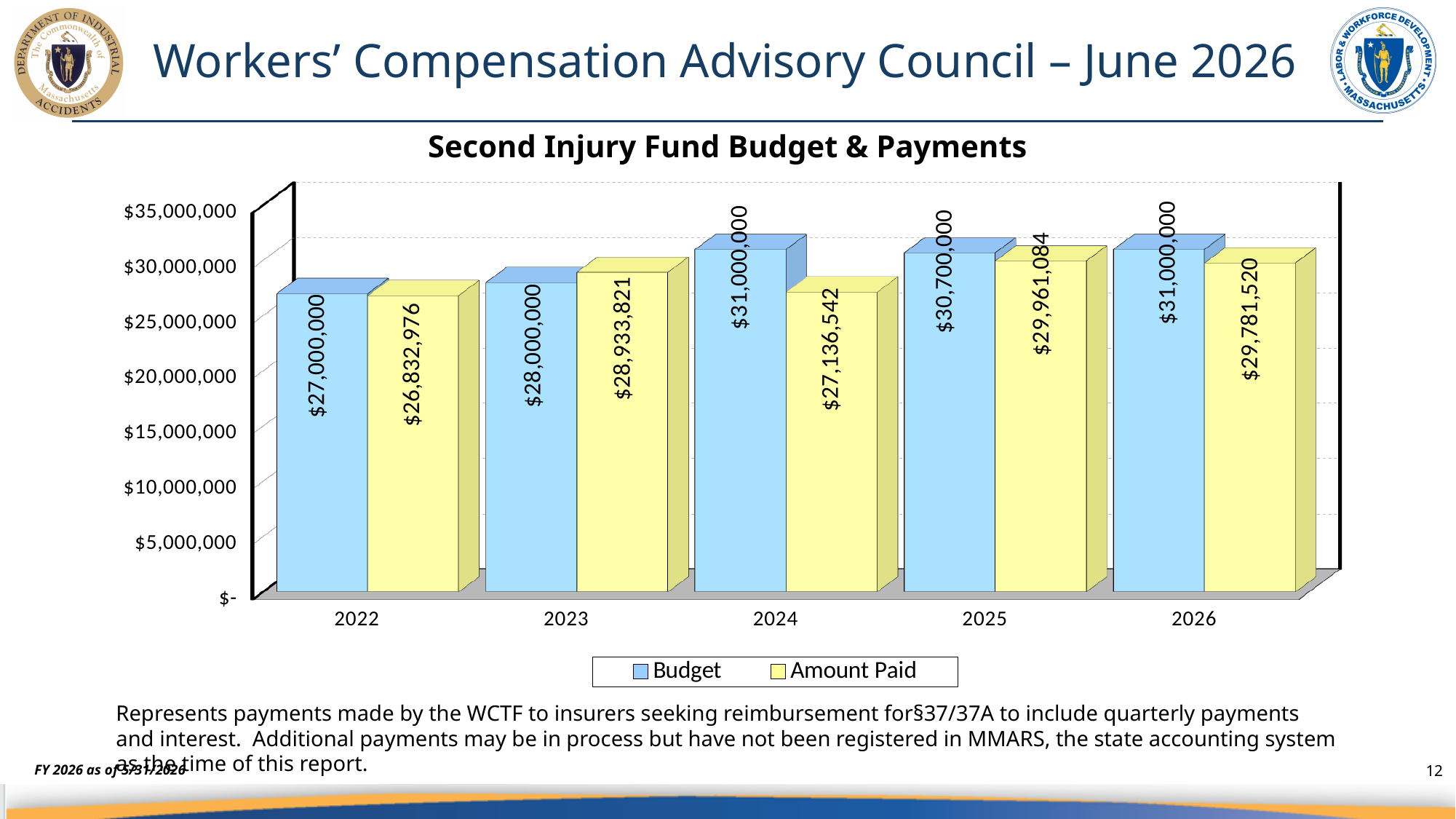
Does the Budget rise or fall from 2022 to 2024? Rise Which year has the highest Amount Paid? 2025 Which year has the lowest Amount Paid? 2022 Which year has the lowest Budget? 2022 In 2023, which is larger: the Budget or the Amount Paid? Amount Paid What kind of chart is shown on the slide? Bar chart What is the Budget value for 2024? $31,000,000 How many series does the legend list? 2 What is the difference between the Budget and the Amount Paid in 2022? $167,024 How many years are shown on the x axis? 5 What is the Amount Paid value for 2025? $29,961,084 What is the difference between the Budget and the Amount Paid in 2024? $3,863,458